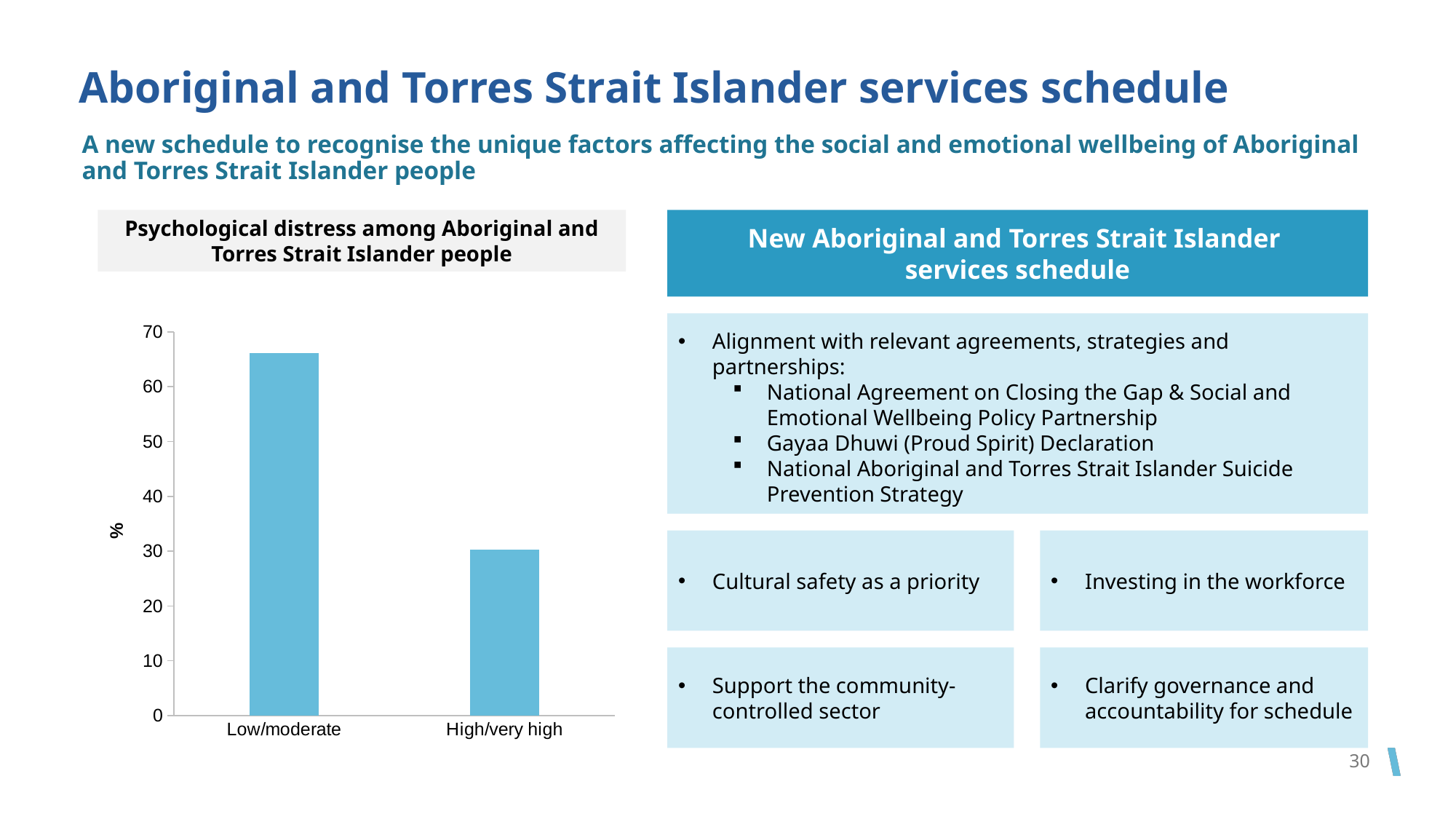
Is the value for High/very high in the psychological distress chart greater or less than 40? less Is the value for Low/moderate in the psychological distress chart greater or less than 60? greater What kind of chart is shown under the title "Psychological distress among Aboriginal and Torres Strait Islander people"? Bar chart What is the label on the y axis of the psychological distress chart? % Is the value for High/very high in the psychological distress chart greater or less than 20? greater Which category has the highest bar in the psychological distress chart? Low/moderate In the psychological distress chart, which is larger: the value for Low/moderate or the value for High/very high? Low/moderate What is the title of the chart on the left of the slide? Psychological distress among Aboriginal and Torres Strait Islander people Which category has the lowest bar in the psychological distress chart? High/very high Do the bar values rise or fall from left to right across the x axis of the psychological distress chart? Fall How many categories are plotted on the x axis of the psychological distress chart? 2